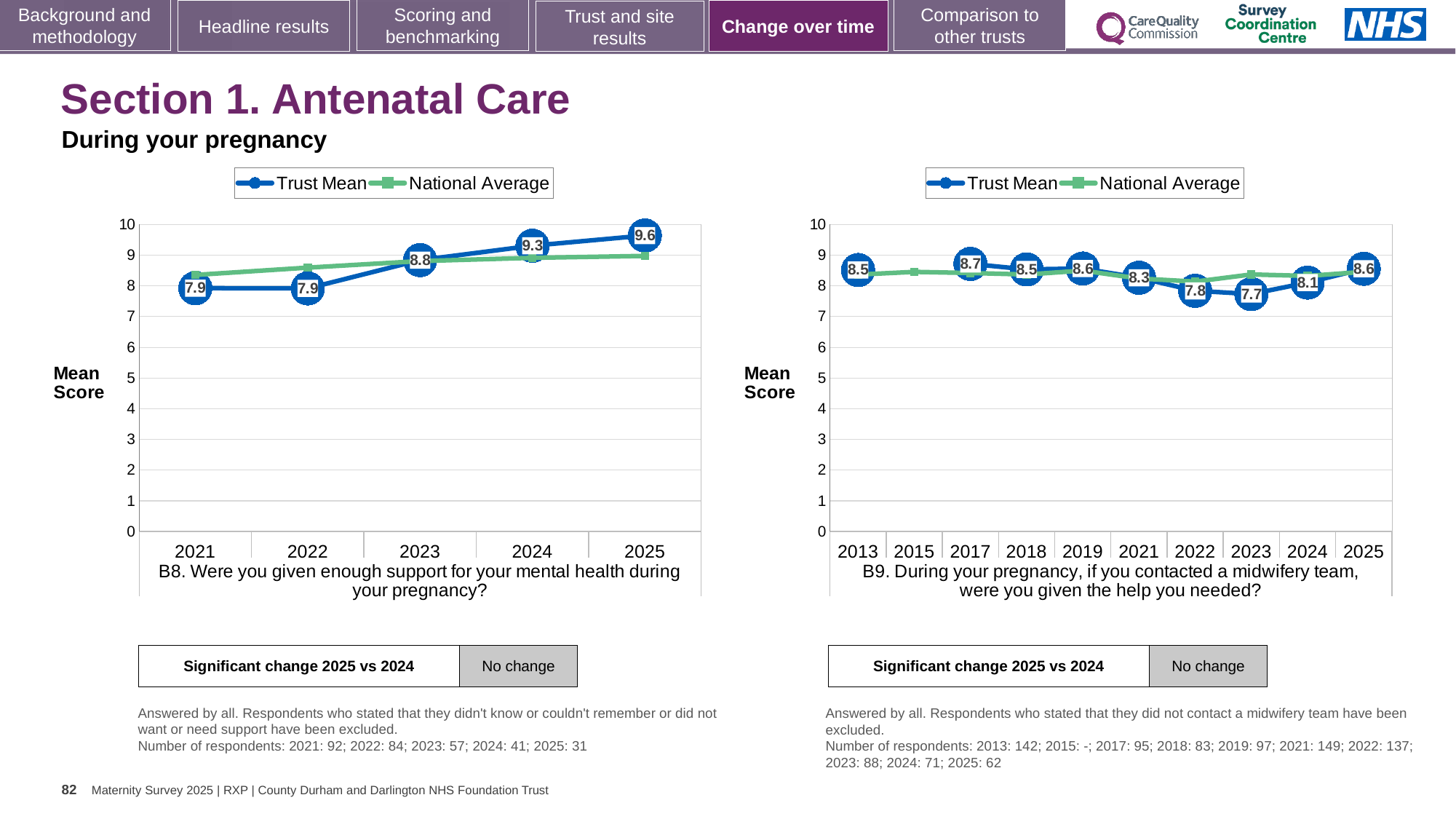
In the B9 chart on the right, which year has the lowest Trust Mean? 2023 How many series does the legend of the B9 chart on the right list? 2 In the B9 chart on the right, which year has the highest Trust Mean? 2017 In the B8 chart on the left, what is the Trust Mean for 2025? 9.6 In the B9 chart on the right, is the Trust Mean for 2022 larger or smaller than the Trust Mean for 2024? smaller In the B9 chart on the right, what is the Trust Mean for 2023? 7.7 In the B8 chart on the left, does the Trust Mean rise or fall from 2021 to 2025? rise In the B9 chart on the right, is the National Average for 2025 greater or less than 7? greater In the B8 chart on the left, what is the difference between the Trust Mean in 2025 and in 2023? 0.8 In the B8 chart on the left, what is the Trust Mean for 2021? 7.9 In the B8 chart on the left, how many years are shown on the x axis? 5 In the B8 chart on the left, which year has the highest Trust Mean? 2025